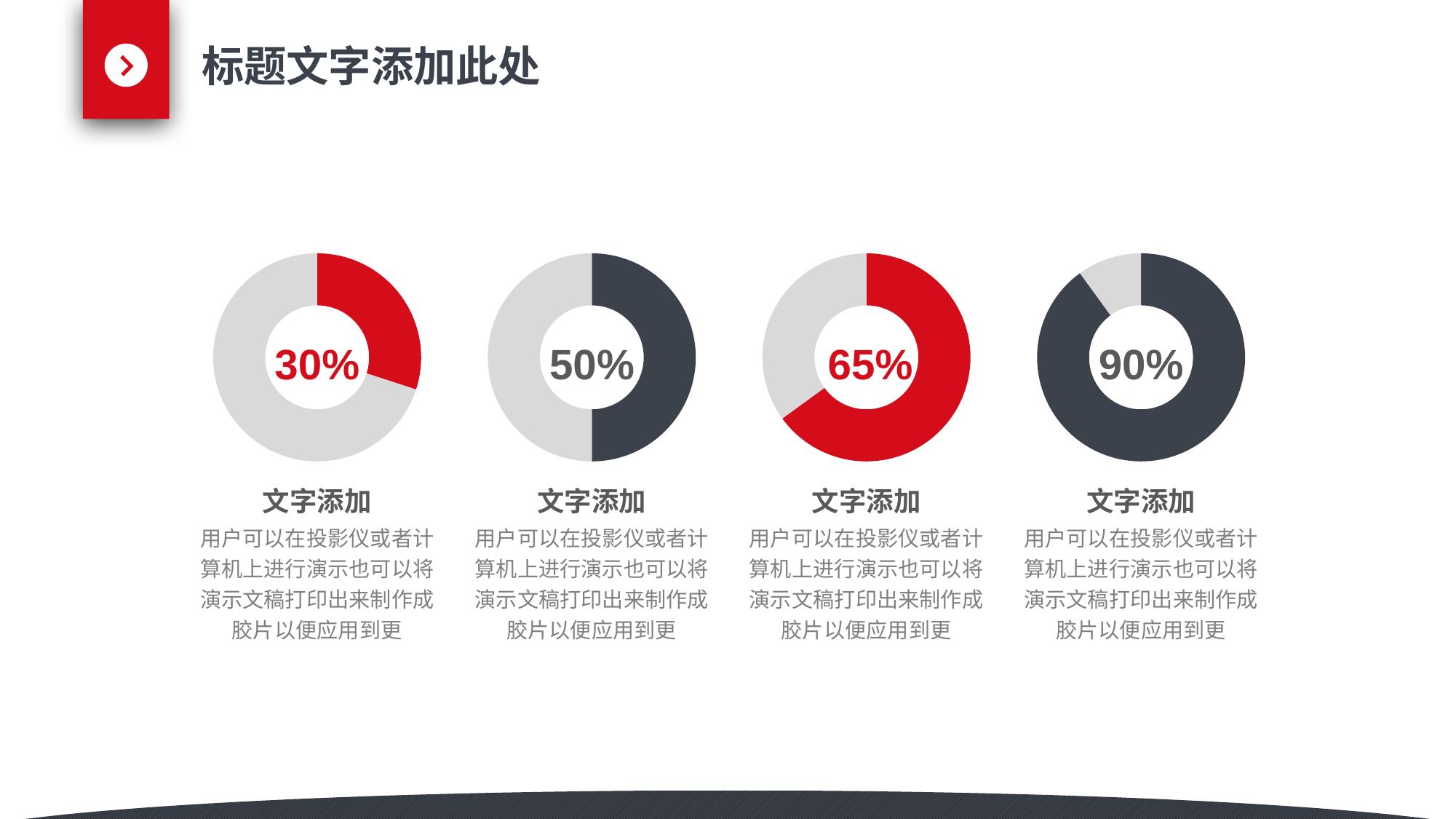
Which is larger, the percentage in the second donut chart from the left or the percentage in the third donut chart from the left? The third (65%) What value is shown in the centre of the rightmost donut chart? 90% What value is shown in the centre of the second donut chart from the left? 50% What is the difference between the percentages shown in the third and second donut charts from the left? 15% What kind of chart is used to display the percentages on this slide? Donut chart What colour is the filled portion of the third donut chart from the left (65%)? Red Which donut chart shows the lowest percentage? The leftmost one (30%) What is the difference between the percentage in the rightmost donut chart and the percentage in the leftmost donut chart? 60% Which donut chart shows the highest percentage? The rightmost one (90%) What value is shown in the centre of the third donut chart from the left? 65% What value is shown in the centre of the leftmost donut chart? 30% How many donut charts are on the slide? 4